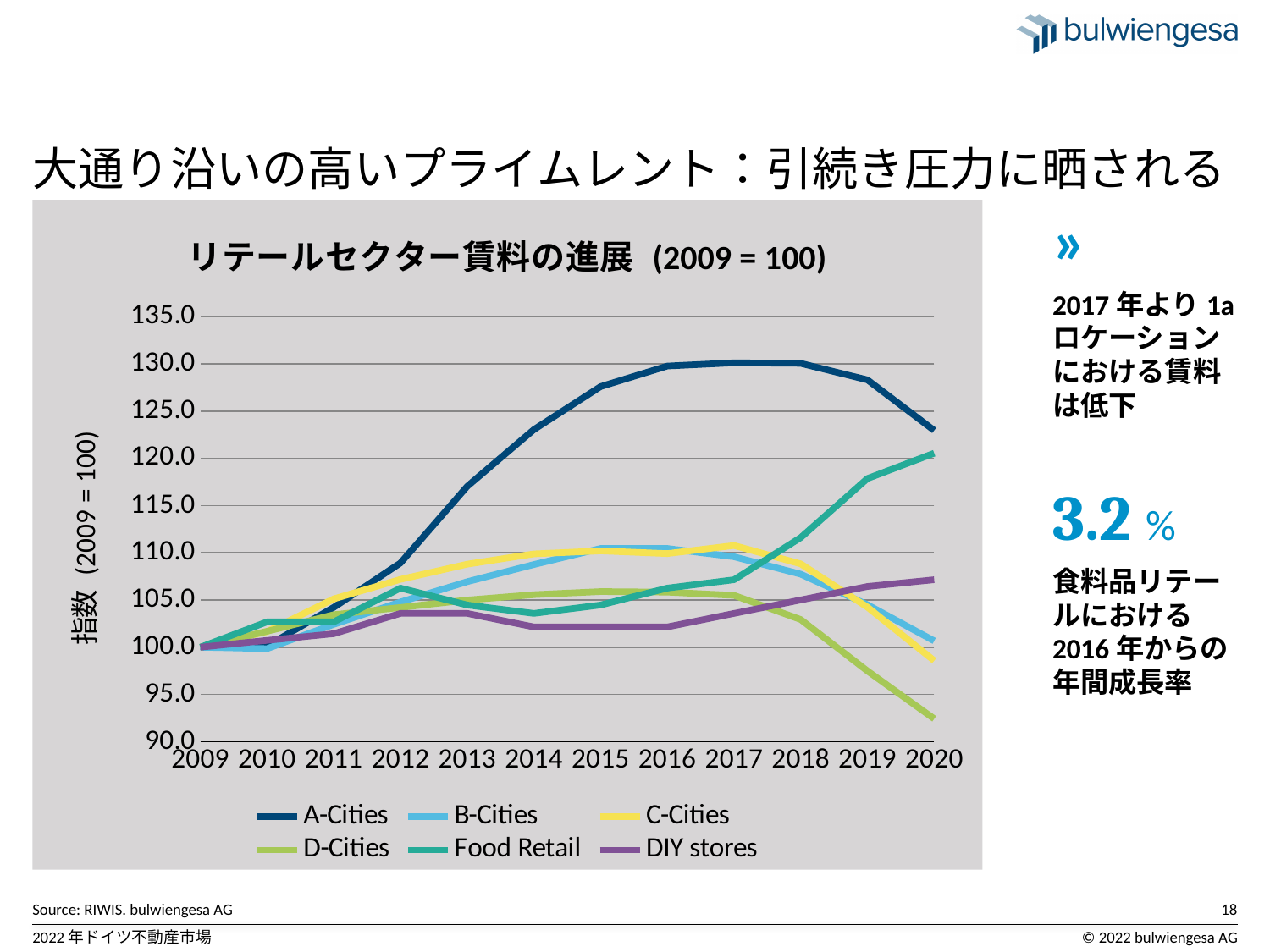
Is the value for A-Cities in 2020 greater or less than 120.0? greater Does the A-Cities line rise or fall from 2017 to 2020? fall How many years are shown on the x axis of the chart? 12 What is the index value for A-Cities in 2009? 100.0 Which series has the lowest value in 2020? D-Cities What type of chart is shown on the slide? line chart Is the value for Food Retail in 2020 greater or less than 115.0? greater Which series has the highest value in 2020? A-Cities What is the title of the chart? リテールセクター賃料の進展 (2009 = 100) Is the value for D-Cities in 2020 greater or less than 95.0? less How many series does the chart legend list? 6 Which is larger in 2016, the value for A-Cities or the value for Food Retail? A-Cities